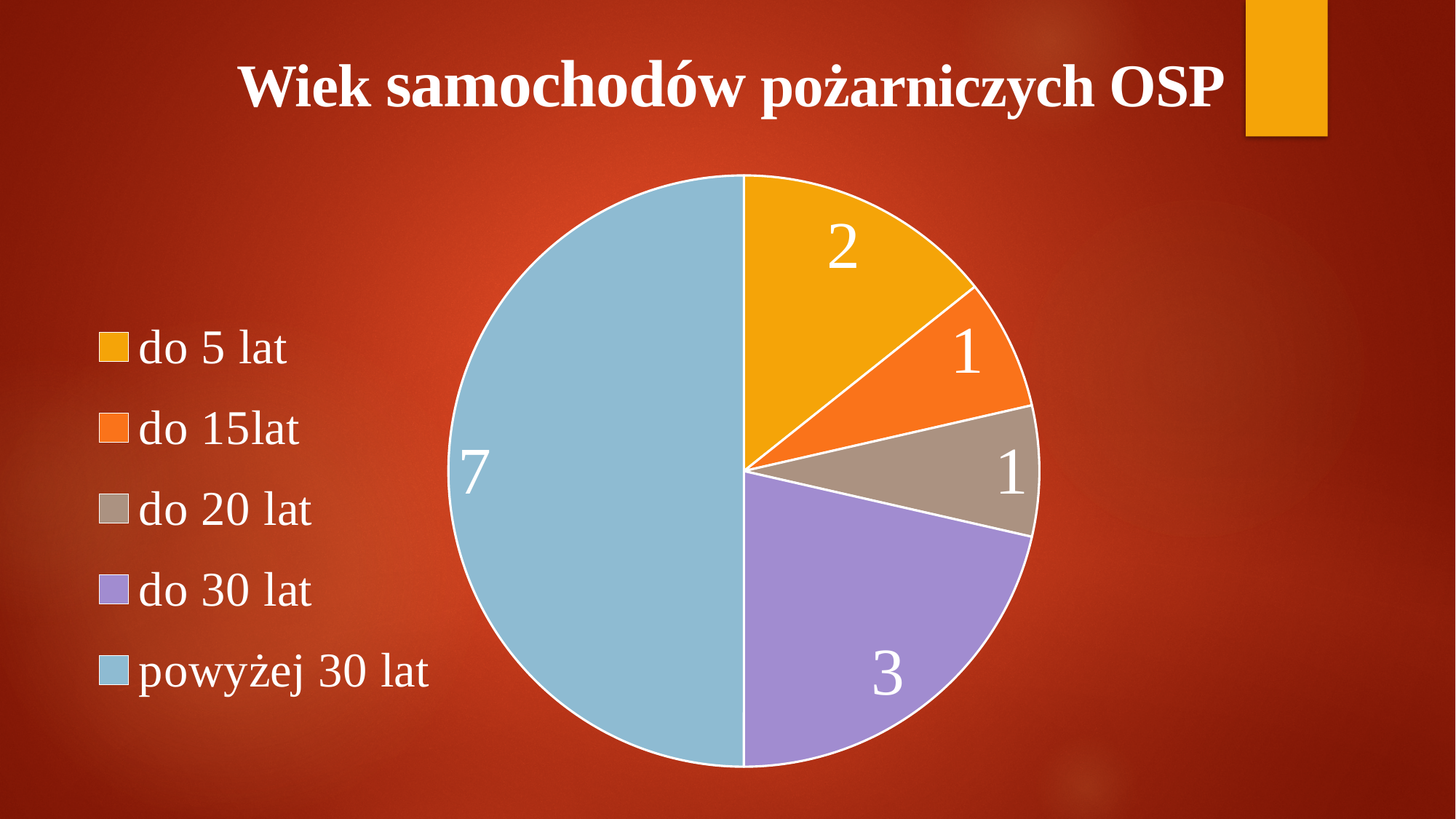
What is the value for "do 30 lat"? 3 What colour is the slice for "do 30 lat"? purple What share of the pie does the "powyżej 30 lat" slice represent? 50% What is the value for "do 5 lat"? 2 What kind of chart is shown on the slide? pie chart What is the value for "powyżej 30 lat"? 7 How many categories does the pie chart have? 5 Which category has the largest slice? powyżej 30 lat What is the difference between the values for "powyżej 30 lat" and "do 30 lat"? 4 Which is larger, the value for "do 5 lat" or the value for "do 30 lat"? do 30 lat What is the title of the chart? Wiek samochodów pożarniczych OSP What is the value for "do 20 lat"? 1